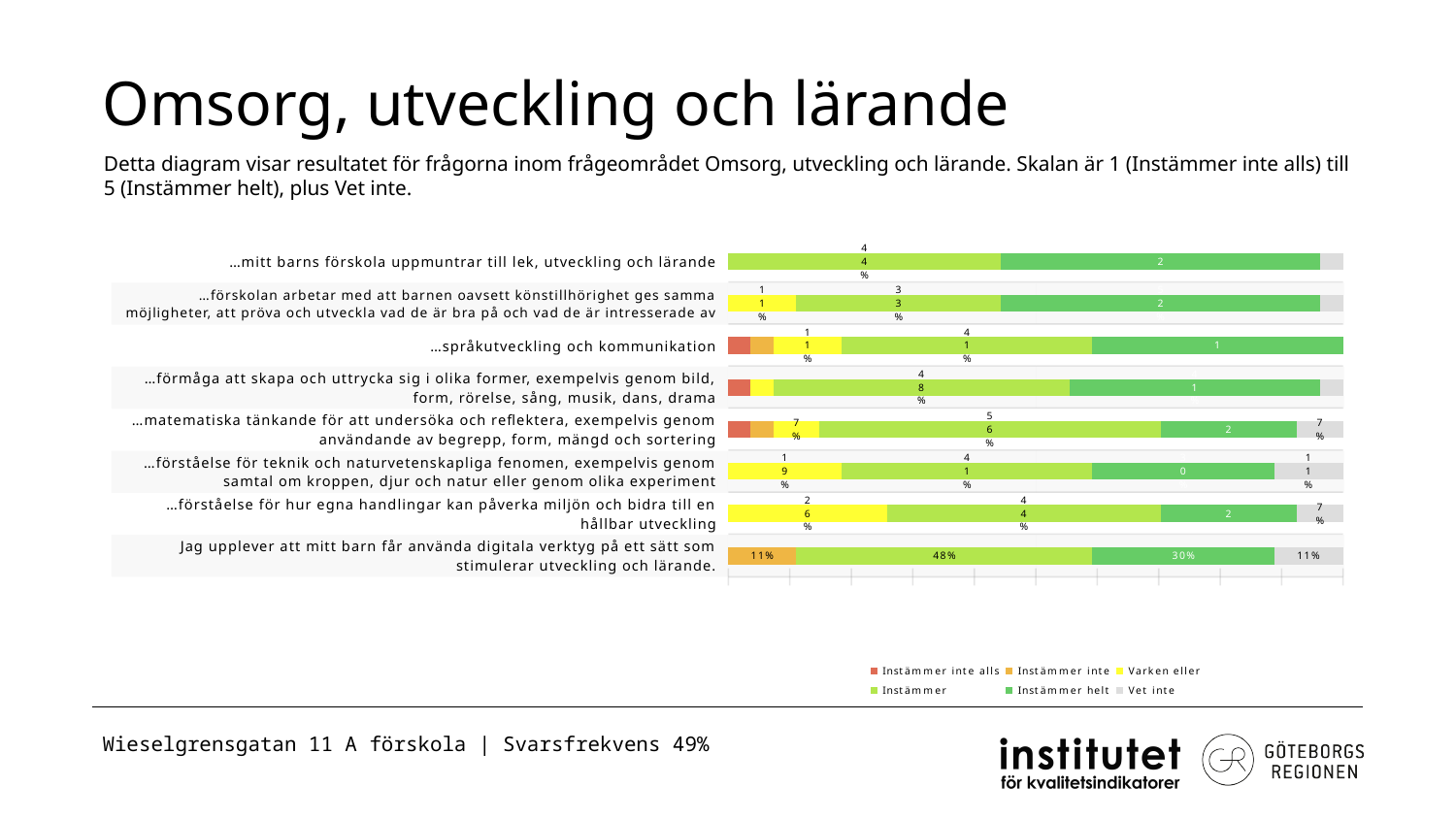
What is the value of the 'Vet inte' segment for the statement about digitala verktyg? 11% For the statement about digitala verktyg, which is larger: the 'Instämmer' segment or the 'Instämmer helt' segment? Instämmer What is the value of the 'Instämmer' segment for the statement 'Jag upplever att mitt barn får använda digitala verktyg på ett sätt som stimulerar utveckling och lärande'? 48% What kind of chart is shown on the slide? Stacked bar chart For the statement about digitala verktyg, what is the difference between the 'Instämmer' segment and the 'Instämmer helt' segment? 18 percentage points What is the value of the 'Instämmer helt' segment for the statement about digitala verktyg? 30% How many survey statements (categories) are plotted in the chart? 8 What is the title of the slide containing the chart? Omsorg, utveckling och lärande What is the total of all segments in the bar for the statement about digitala verktyg? 100% How many series does the chart legend list? 6 Which legend entry is shown in grey? Vet inte